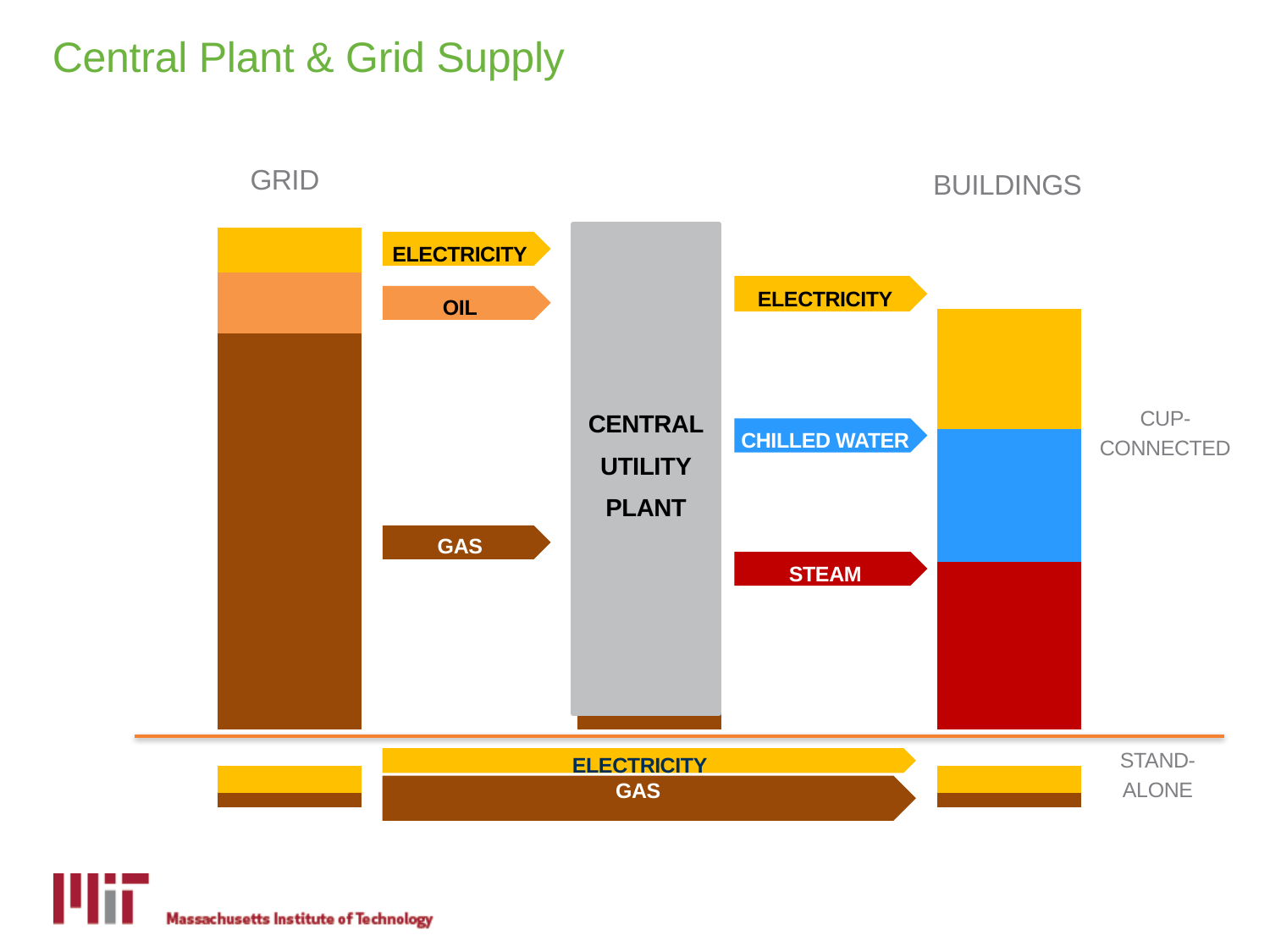
In the CUP-CONNECTED buildings stacked bar, which segment is larger: steam or electricity? Steam How many segments make up the GRID stacked bar on the left? 3 In the CUP-CONNECTED buildings stacked bar, which output (electricity, chilled water or steam) occupies the largest segment? Steam Which three outputs flow from the Central Utility Plant to the CUP-connected buildings? Electricity, chilled water, steam In the GRID stacked bar, which supply (electricity, oil or gas) occupies the largest segment? Gas What does the grey block between the GRID and BUILDINGS bars represent? Central Utility Plant In the GRID stacked bar, which segment is larger: gas or electricity? Gas How many segments make up the CUP-CONNECTED buildings stacked bar on the right? 3